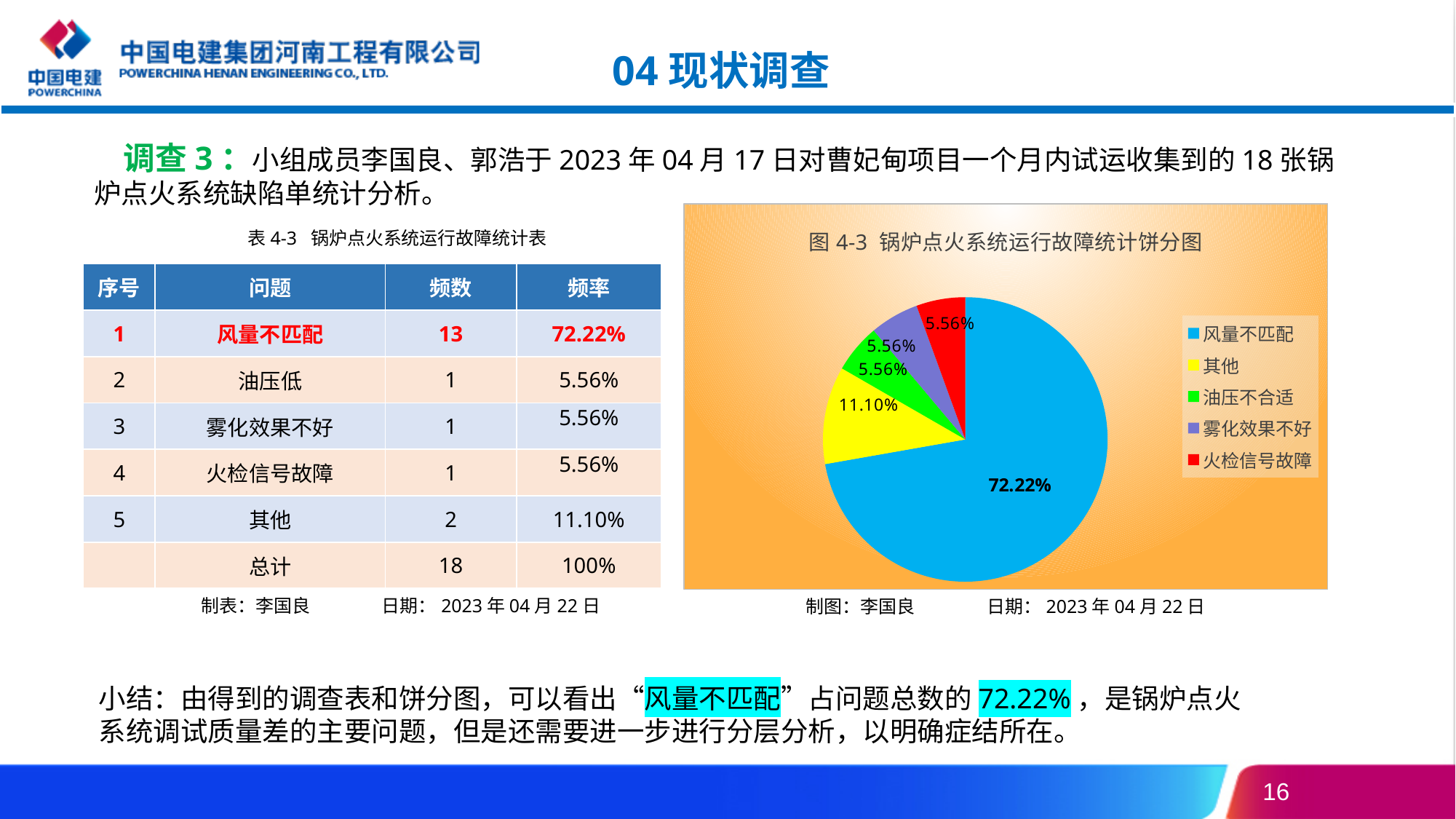
What share of the pie does 风量不匹配 account for? 72.22% What is the difference in percentage points between the 风量不匹配 slice and the 其他 slice? 61.12 Which is larger in the pie chart, 其他 or 油压不合适? 其他 What colour is the 风量不匹配 slice in the pie chart? blue What type of chart is shown on the slide? pie chart Is the share for 风量不匹配 greater or less than 50%? greater What share of the pie does 其他 account for? 11.10% What share of the pie does 火检信号故障 account for? 5.56% How many slices does the pie chart have? 5 Which category has the largest slice in the pie chart? 风量不匹配 How many entries does the pie chart's legend list? 5 What is the title of the pie chart? 图 4-3 锅炉点火系统运行故障统计饼分图